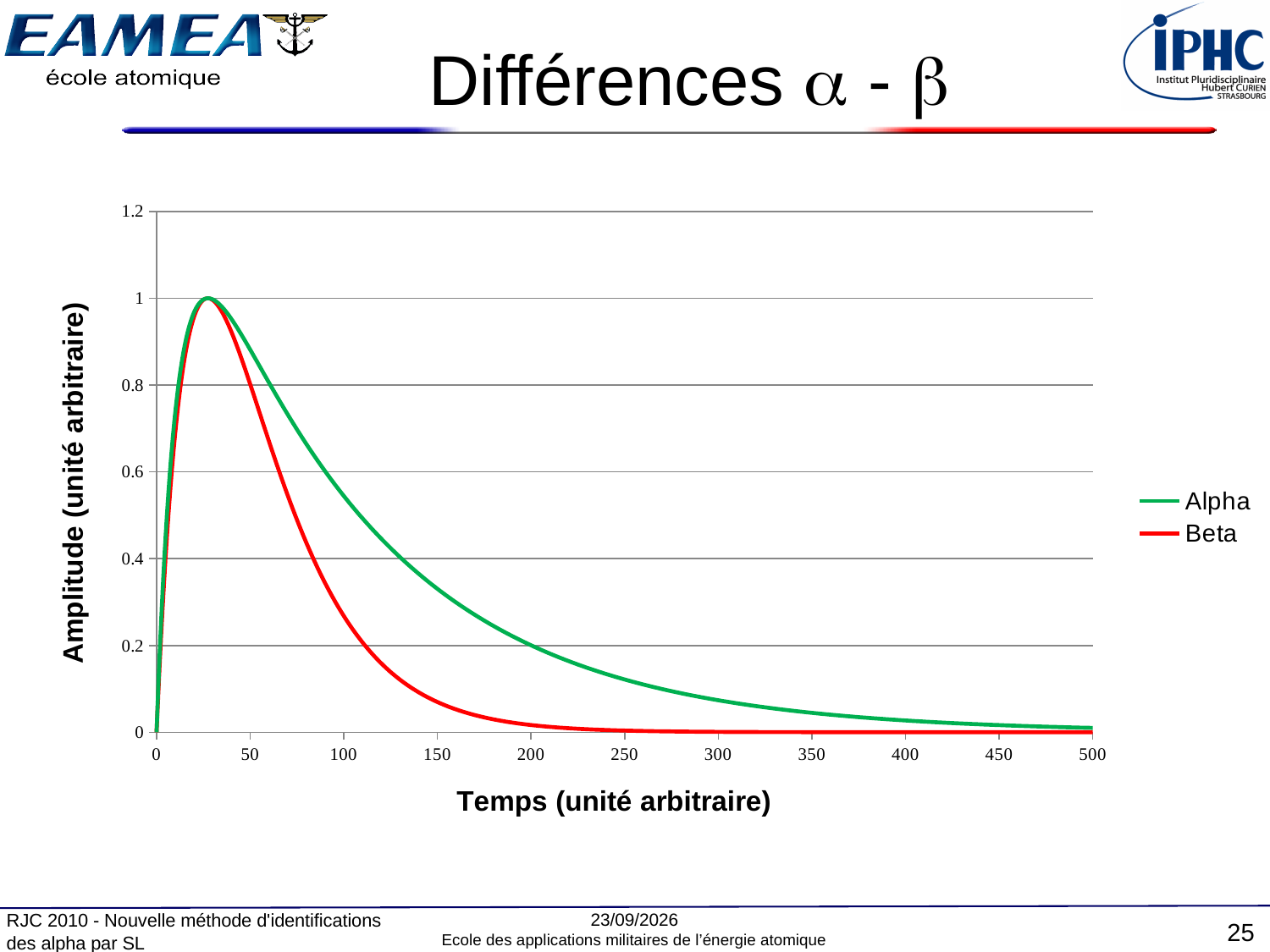
Is the value of the Alpha curve at time 300 greater or less than 0.2? less Is the value of the Beta curve at time 150 greater or less than 0.2? less Is the value of the Beta curve at time 100 greater or less than 0.4? less Which curve decays to zero faster after its peak, Alpha or Beta? Beta After reaching their peak, do the Alpha and Beta curves rise or fall as time increases? fall At time 200, which curve has the higher amplitude, Alpha or Beta? Alpha What kind of chart is shown on the slide? line chart How many series does the legend list? 2 What is the title of the x axis? Temps (unité arbitraire) What are the two series named in the legend? Alpha and Beta